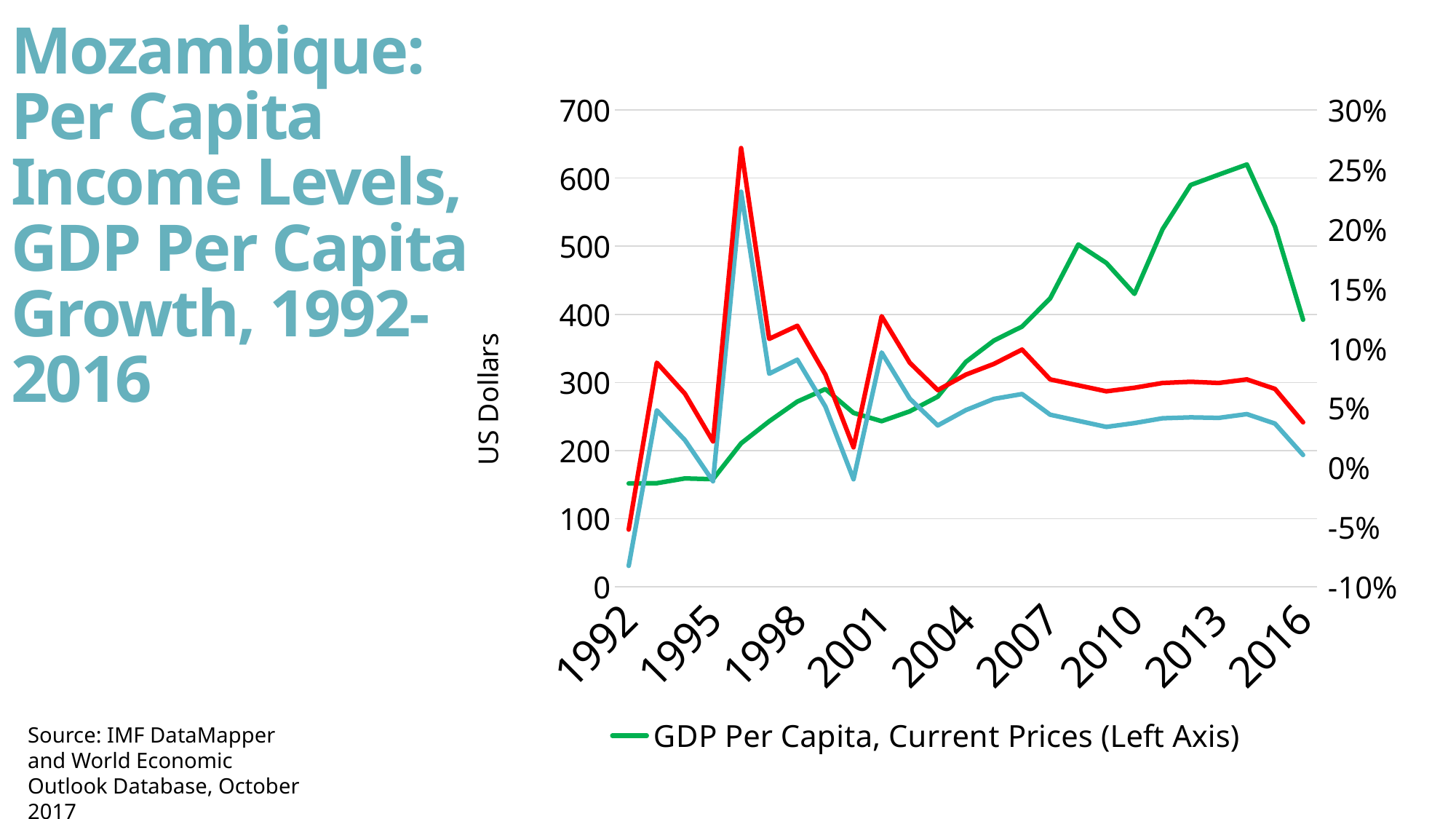
Is the value of GDP Per Capita, Current Prices in 2013 greater or less than 500? greater Which is larger, GDP Per Capita, Current Prices in 2007 or in 2013? 2013 How many series does the legend list? 1 In which year does GDP Per Capita, Current Prices reach its highest value? 2014 What is the title of the slide's chart? Mozambique: Per Capita Income Levels, GDP Per Capita Growth, 1992-2016 Is the value of GDP Per Capita, Current Prices in 1992 greater or less than 200? less Between 2014 and 2016, does GDP Per Capita, Current Prices rise or fall? fall What is the label of the left vertical axis? US Dollars What kind of chart is shown on the slide? line chart Is the value of GDP Per Capita, Current Prices in 2016 greater or less than 300? greater How many year labels are shown on the x axis? 9 Which is larger, GDP Per Capita, Current Prices in 1992 or in 2016? 2016